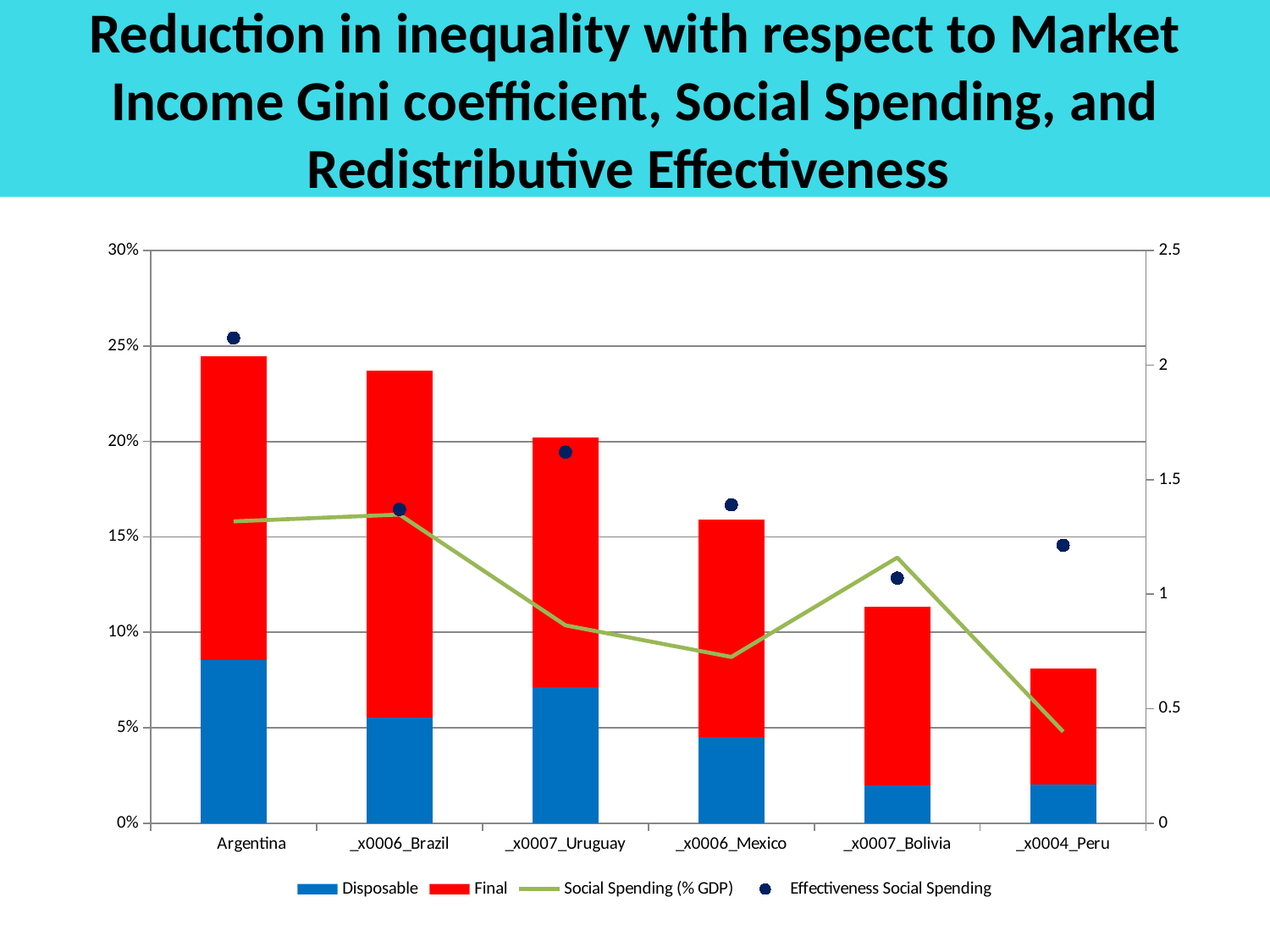
On the right-hand axis, is the Social Spending (% GDP) value for Peru greater or less than 0.5? less How many series does the legend list? 4 On the right-hand axis, is the Effectiveness Social Spending marker for Argentina greater or less than 2? greater Which country has the lowest Social Spending (% GDP) line value? Peru Which is larger, the Disposable value for Argentina or the Disposable value for Uruguay? Argentina Which country has the shortest stacked bar (Disposable plus Final)? Peru How many countries are shown on the x axis? 6 Is the total stacked bar for Peru greater or less than 10%? less Do the total stacked bar heights rise or fall from Argentina on the left to Peru on the right? fall Which country has the tallest stacked bar (Disposable plus Final)? Argentina What colour represents the Final series in the legend? red